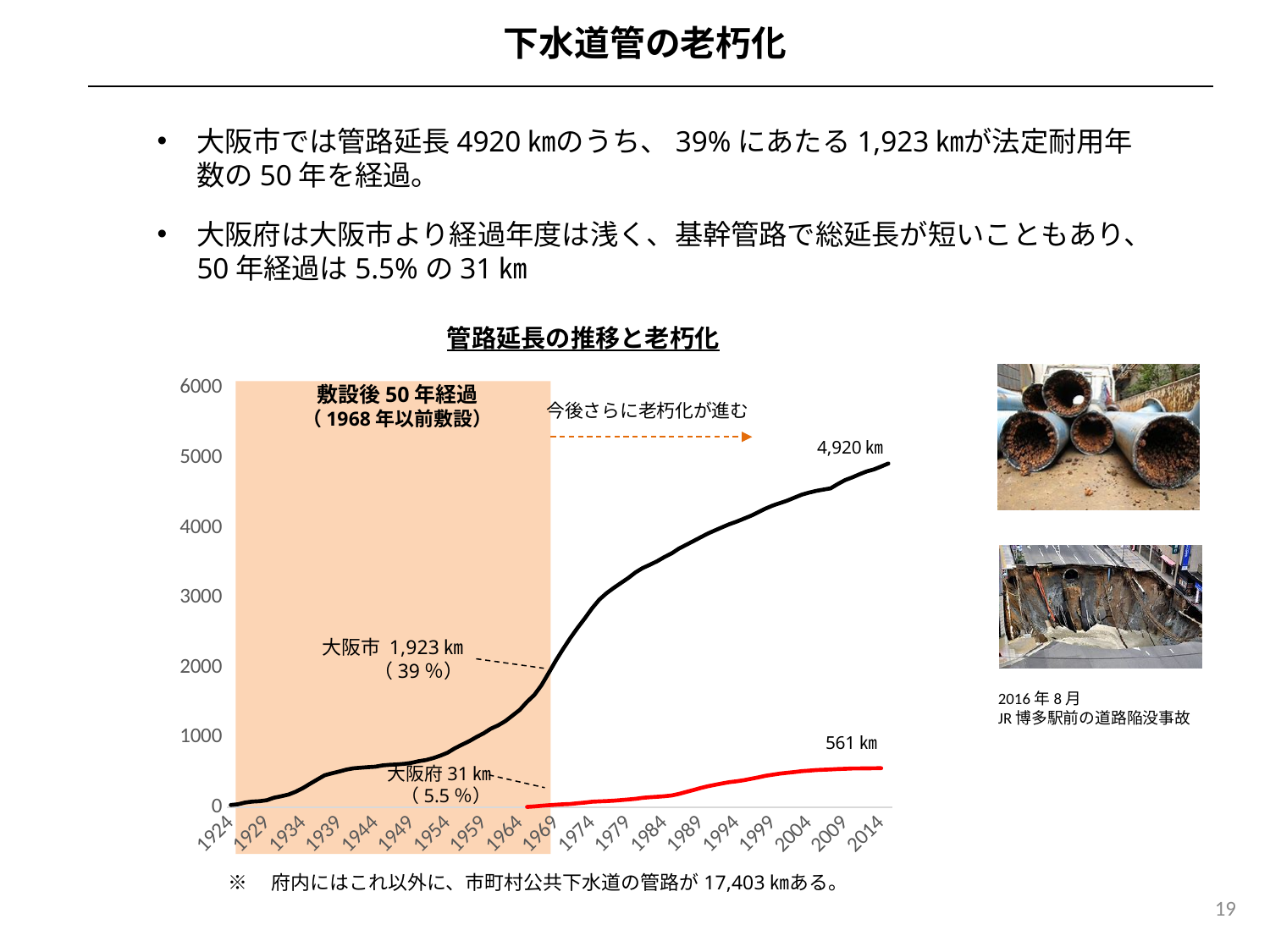
What is the labelled value at the end of the red line (大阪府) in 2014? 561 km What is the difference between the 2014 value of 大阪市 (4,920 km) and its 1968 value (1,923 km)? 2,997 km How many year labels are shown on the x axis? 19 What kind of chart is shown under the heading 管路延長の推移と老朽化? line chart Is the value of the black 大阪市 line in 1979 greater or less than 3000? greater What pipe length for 大阪市 is labelled at the 1968 boundary of the shaded area? 1,923 km What is the labelled value at the end of the black line (大阪市) in 2014? 4,920 km What is the difference between the 2014 values of 大阪市 (4,920 km) and 大阪府 (561 km)? 4,359 km What percentage is shown next to the 大阪府 31 km label? 5.5% Is the value of the black 大阪市 line in 1949 greater or less than 1000? less Which line ends at a higher value in 2014, the black 大阪市 line or the red 大阪府 line? 大阪市 Does the black 大阪市 line rise or fall from 1924 to 2014? rise